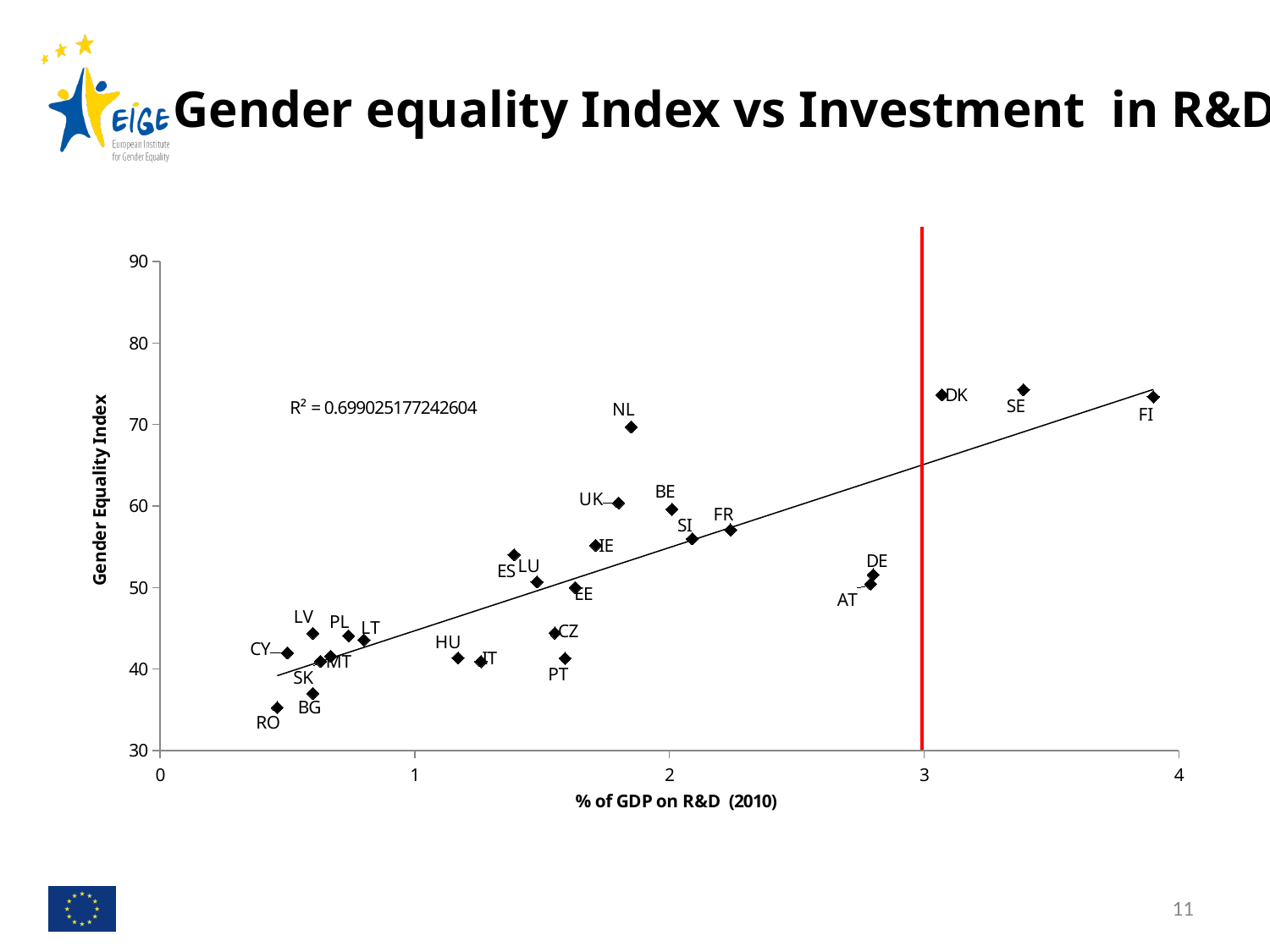
Is the Gender Equality Index for NL greater or less than 60? greater Is the % of GDP on R&D for SE greater or less than 3? greater Which country has the highest % of GDP on R&D? FI What is the title of the y axis? Gender Equality Index Which has a higher % of GDP on R&D, FR or DE? DE What kind of chart is shown on the slide? scatter chart Does the trend line show the Gender Equality Index rising or falling as % of GDP on R&D increases? rising What is the title of the x axis? % of GDP on R&D (2010) Which country has the lowest Gender Equality Index? RO Is the Gender Equality Index for RO greater or less than 40? less Which has a higher Gender Equality Index, NL or UK? NL What R-squared value is printed on the chart? 0.699025177242604